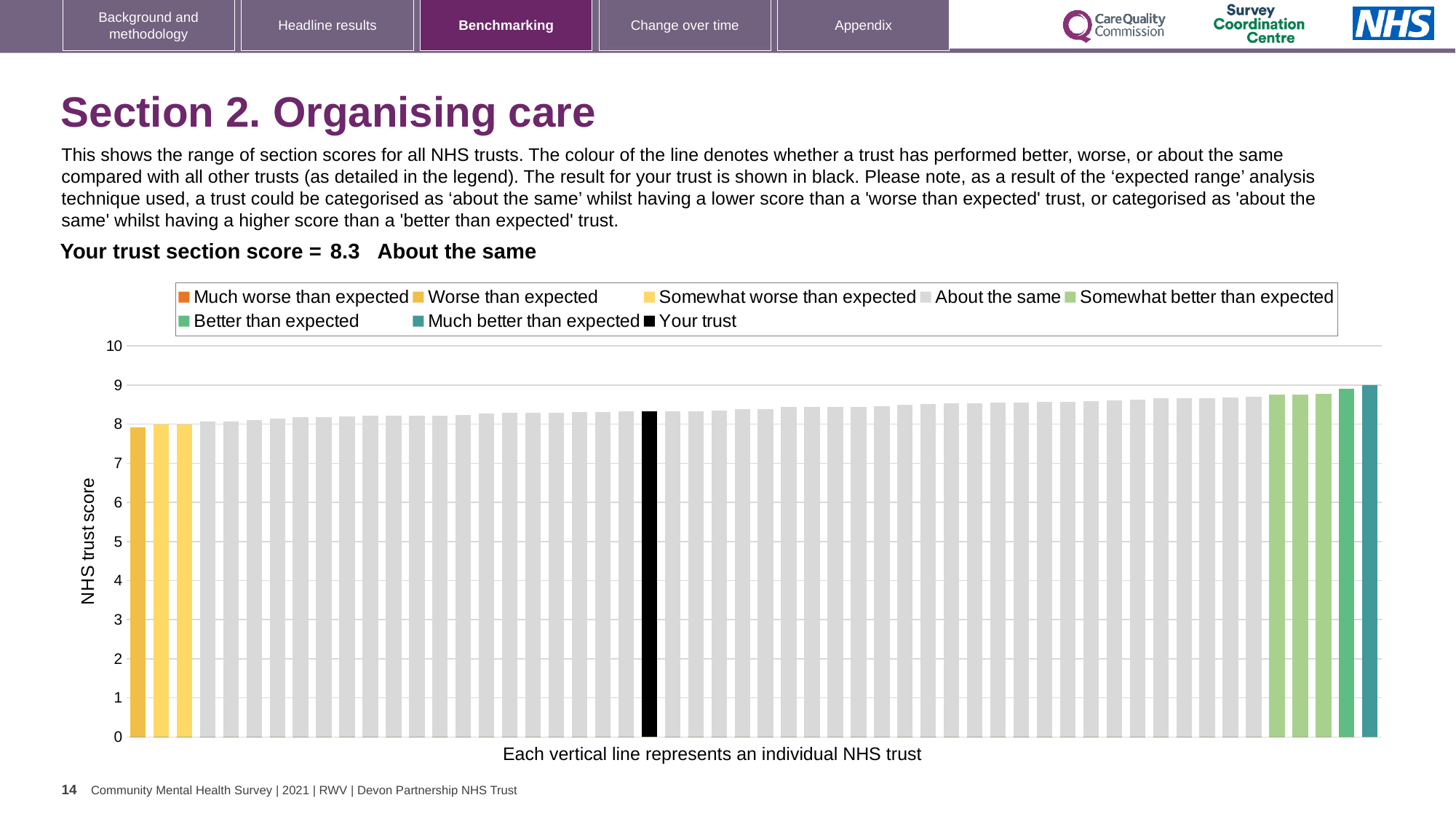
What is the section score for your trust shown on the slide? 8.3 Which category is your trust placed in for this section? About the same What kind of chart is shown on the slide? bar chart Is the value of the rightmost (highest) bar greater or less than 8? greater Do the bar values rise or fall from left to right along the x axis? rise Which bar is higher: the black bar for your trust or the leftmost bar? the black bar for your trust Is the value for your trust (the black bar) greater or less than 8? greater What is the label of the y axis? NHS trust score Is the value of the leftmost (lowest) bar greater or less than 9? less How many entries does the chart legend list? 8 How many bars are coloured teal (Much better than expected)? 1 What is the highest value shown on the y axis? 10